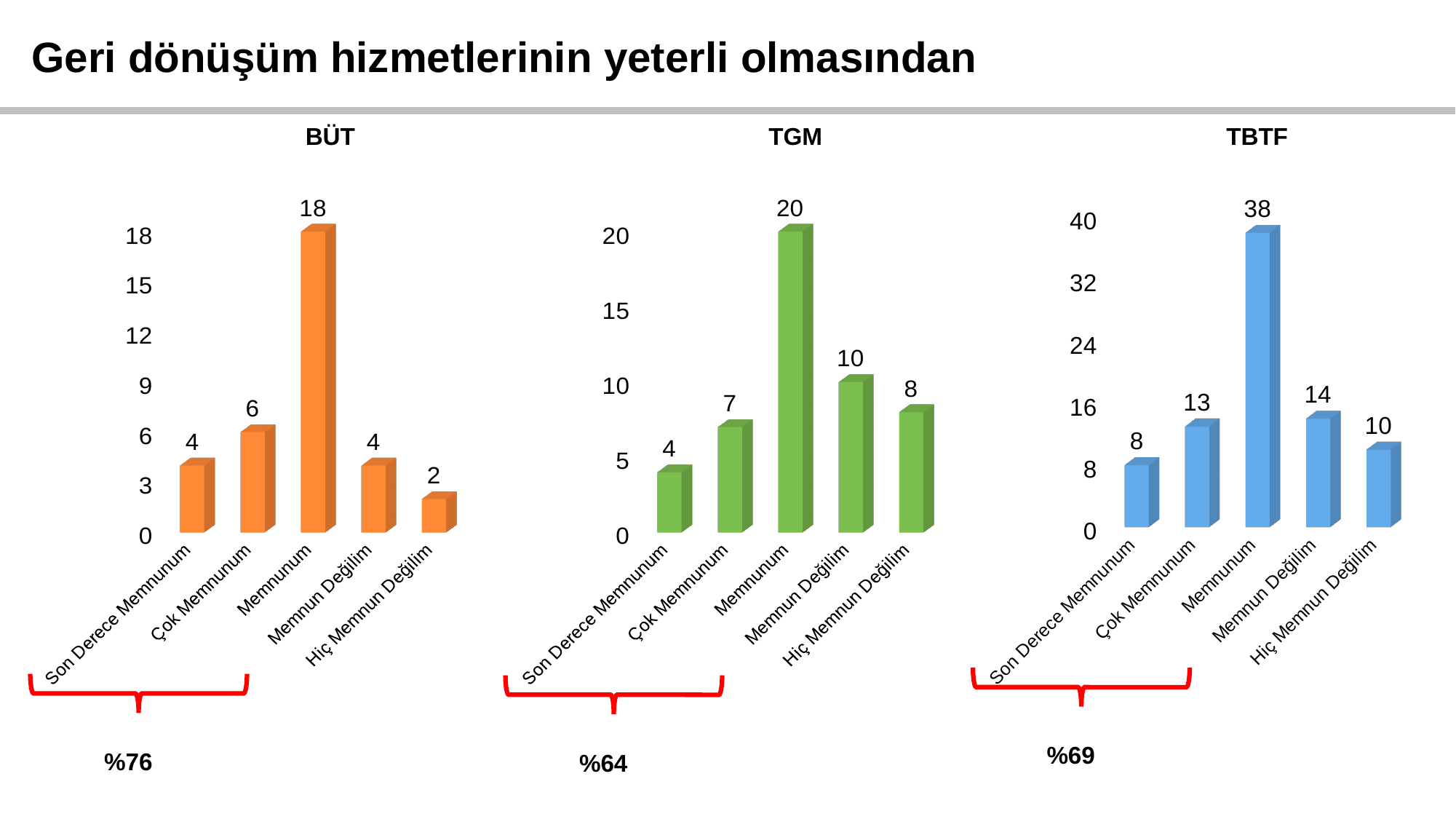
In the BÜT chart, what is the value for Memnunum? 18 In the BÜT chart, how many categories are shown on the x axis? 5 In the TBTF chart, what is the value for Çok Memnunum? 13 In the TGM chart, what is the value for Hiç Memnun Değilim? 8 In the BÜT chart, which category has the lowest value? Hiç Memnun Değilim In the TBTF chart, which category has the highest value? Memnunum In the TBTF chart, is the value for Memnunum greater or less than 32? greater What percentage is shown under the bracket beneath the BÜT chart? %76 What kind of chart is the TGM chart? Bar chart In the TGM chart, which is larger, Çok Memnunum or Son Derece Memnunum? Çok Memnunum In the TBTF chart, what is the difference between Memnunum and Hiç Memnun Değilim? 28 In the TGM chart, what is the difference between Memnunum and Memnun Değilim? 10